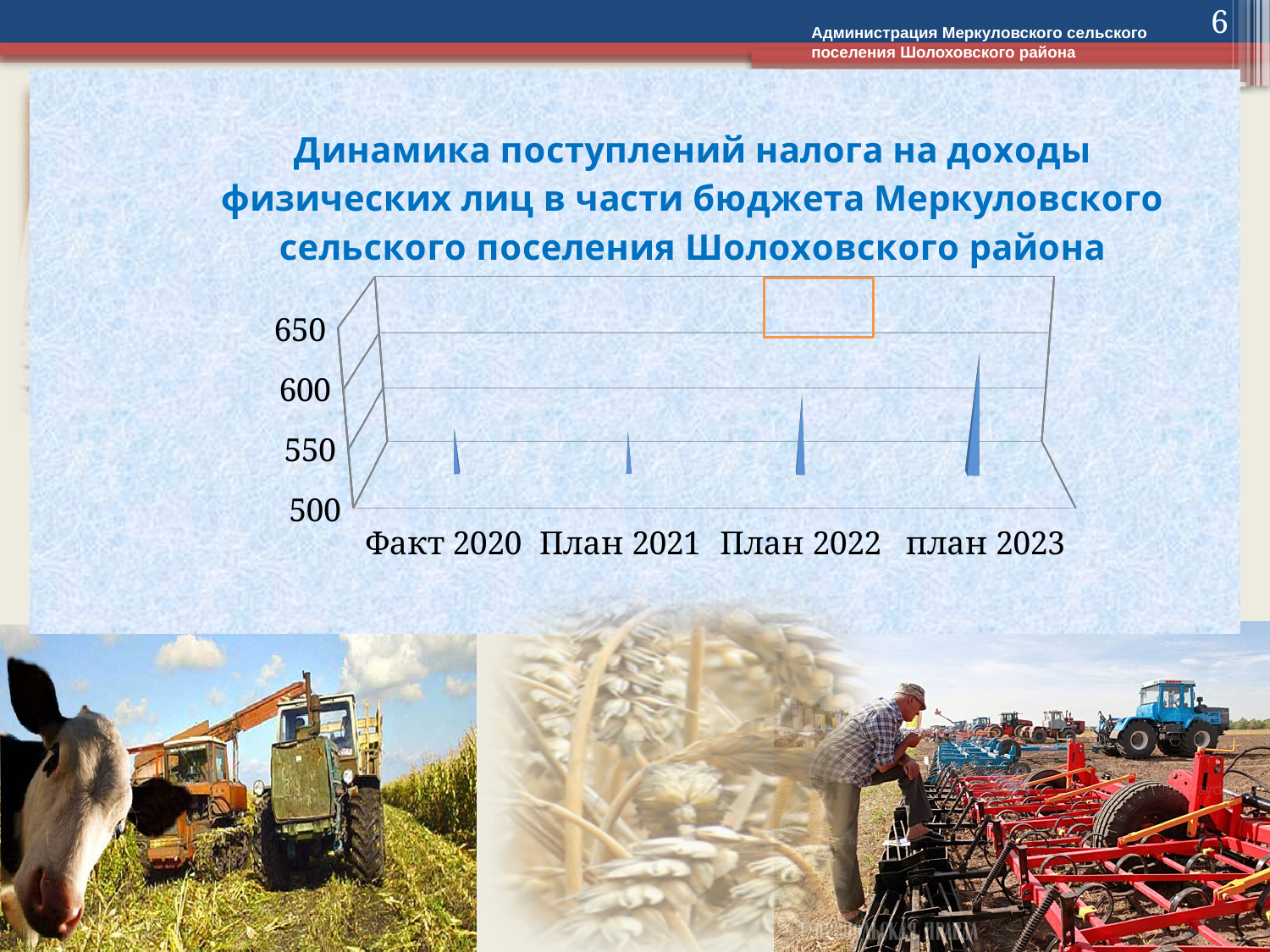
Do the values rise or fall from Факт 2020 to план 2023? rise What is the highest tick value shown on the vertical axis? 650 Which is larger, the value for план 2023 or the value for Факт 2020? план 2023 What is the lowest tick value shown on the vertical axis? 500 How many categories are shown on the x axis of the chart? 4 Which is larger, the value for План 2022 or the value for План 2021? План 2022 Is the value for Факт 2020 greater or less than 600? less Is the value for План 2022 greater or less than 550? greater Which category has the highest value in the chart? план 2023 Is the value for План 2021 greater or less than 600? less